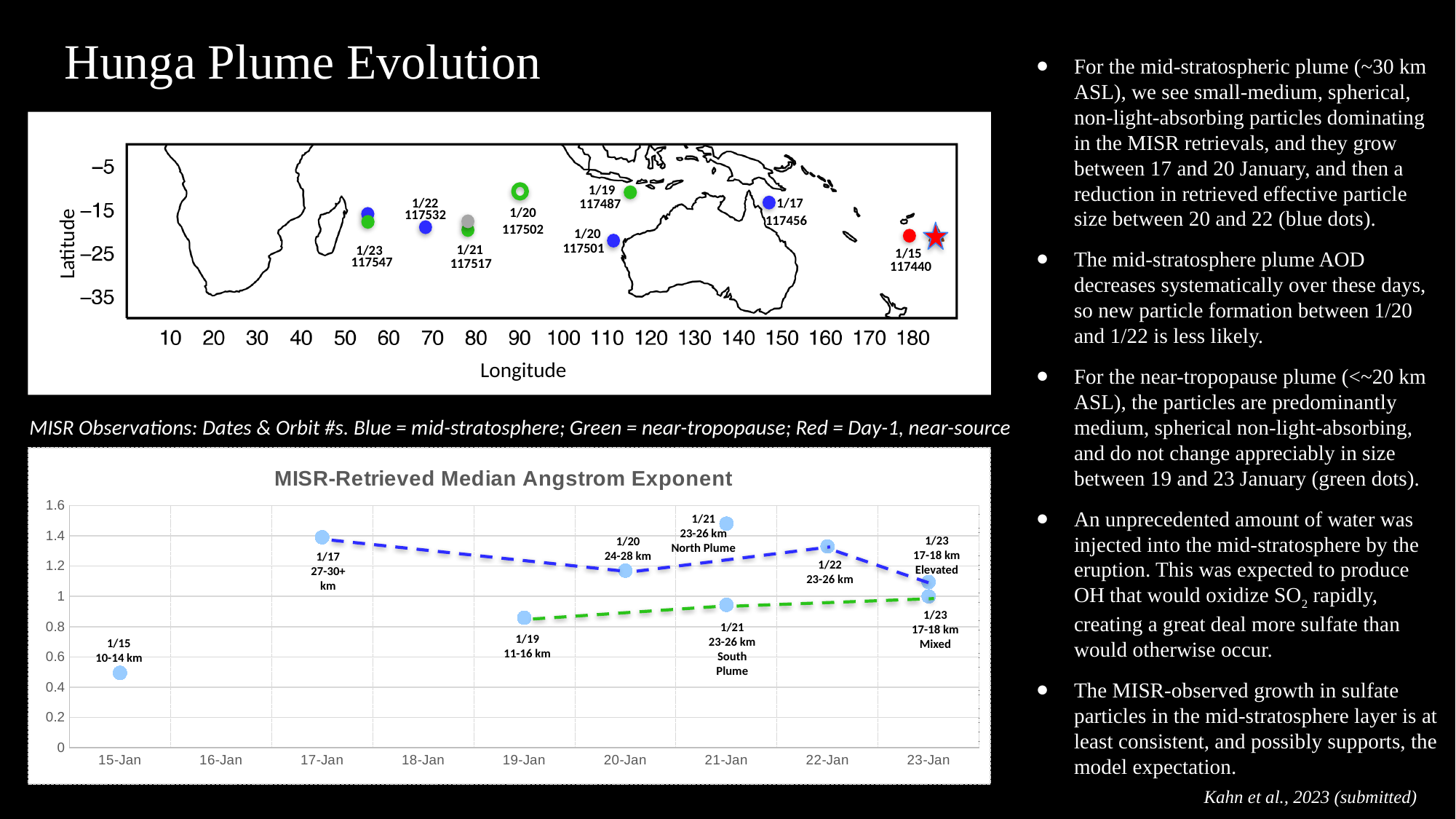
In the bottom chart, which is larger: the 1/21 North Plume value or the 1/21 South Plume value? 1/21 North Plume In the bottom chart, which labeled point has the highest Angstrom exponent? 1/21 23-26 km North Plume In the bottom chart, is the value for the 1/19 11-16 km point greater or less than 1? less In the bottom chart, does the green dashed line rise or fall from 19-Jan to 23-Jan? rise In the bottom chart, how many data points are plotted? 9 In the bottom chart, which labeled point has the lowest Angstrom exponent? 1/15 10-14 km In the bottom chart, is the value for the 1/17 27-30+ km point greater or less than 1.2? greater In the bottom chart, is the value for the 1/15 10-14 km point greater or less than 0.6? less What kind of chart is the bottom chart, MISR-Retrieved Median Angstrom Exponent? line chart In the bottom chart, what is the chart title? MISR-Retrieved Median Angstrom Exponent In the top map chart, what orbit number is labeled for the 1/17 observation? 117456 In the bottom chart, does the blue dashed line rise or fall from 17-Jan to 20-Jan? fall